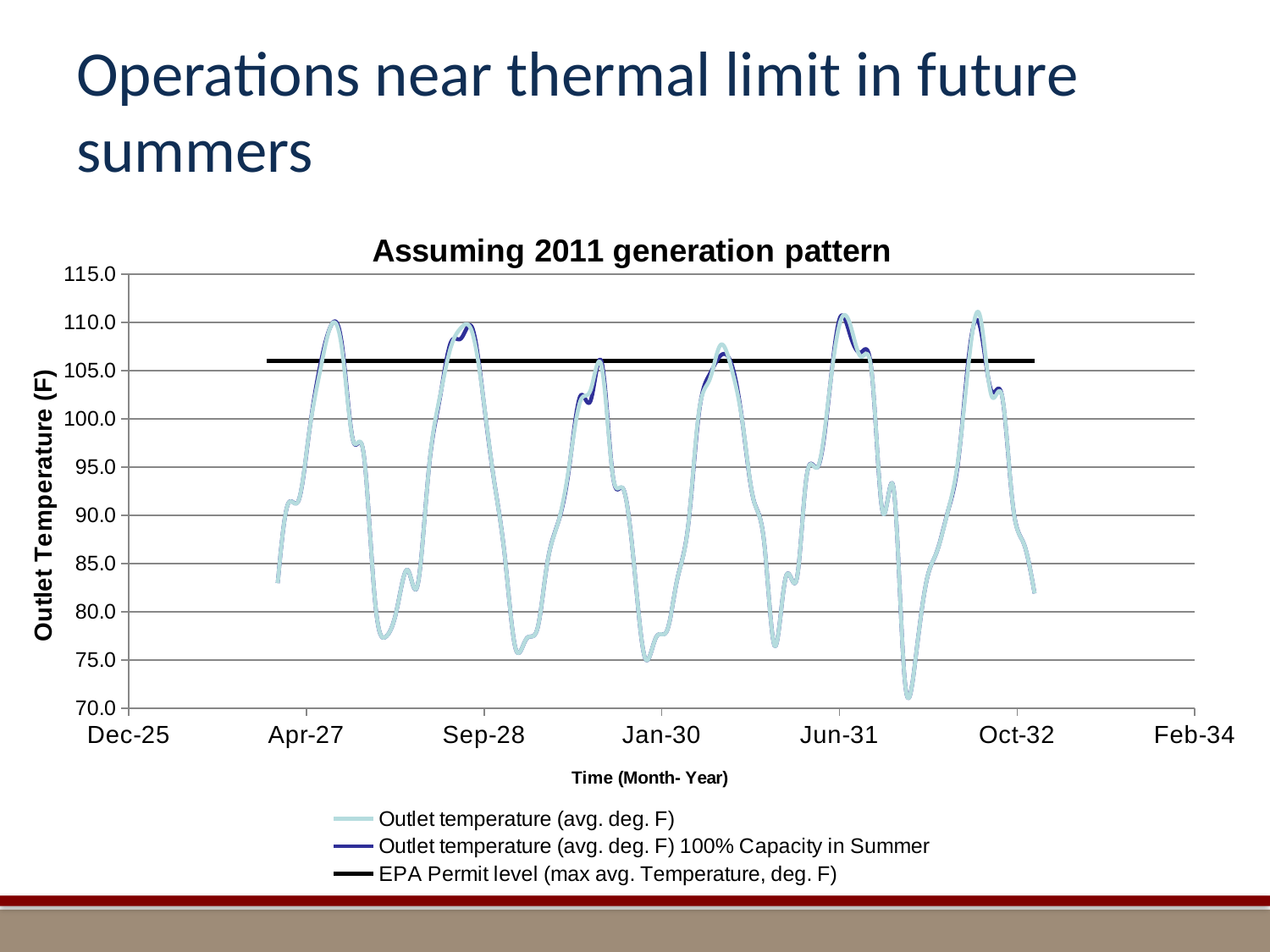
Is the trough of the outlet temperature line just after Sep-28 greater or less than 80? less What is the title of the chart? Assuming 2011 generation pattern Is the lowest trough of the outlet temperature line, just after Jun-31, greater or less than 75? less What is the label of the vertical axis? Outlet Temperature (F) Is the peak of the outlet temperature line just before Oct-32 greater or less than 105? greater What kind of chart is shown on the slide? line chart How many tick labels are shown on the horizontal (time) axis? 7 How many series does the legend list? 3 Which is larger: the peak of the outlet temperature line near Apr-27 or the trough just after Jun-31? the peak near Apr-27